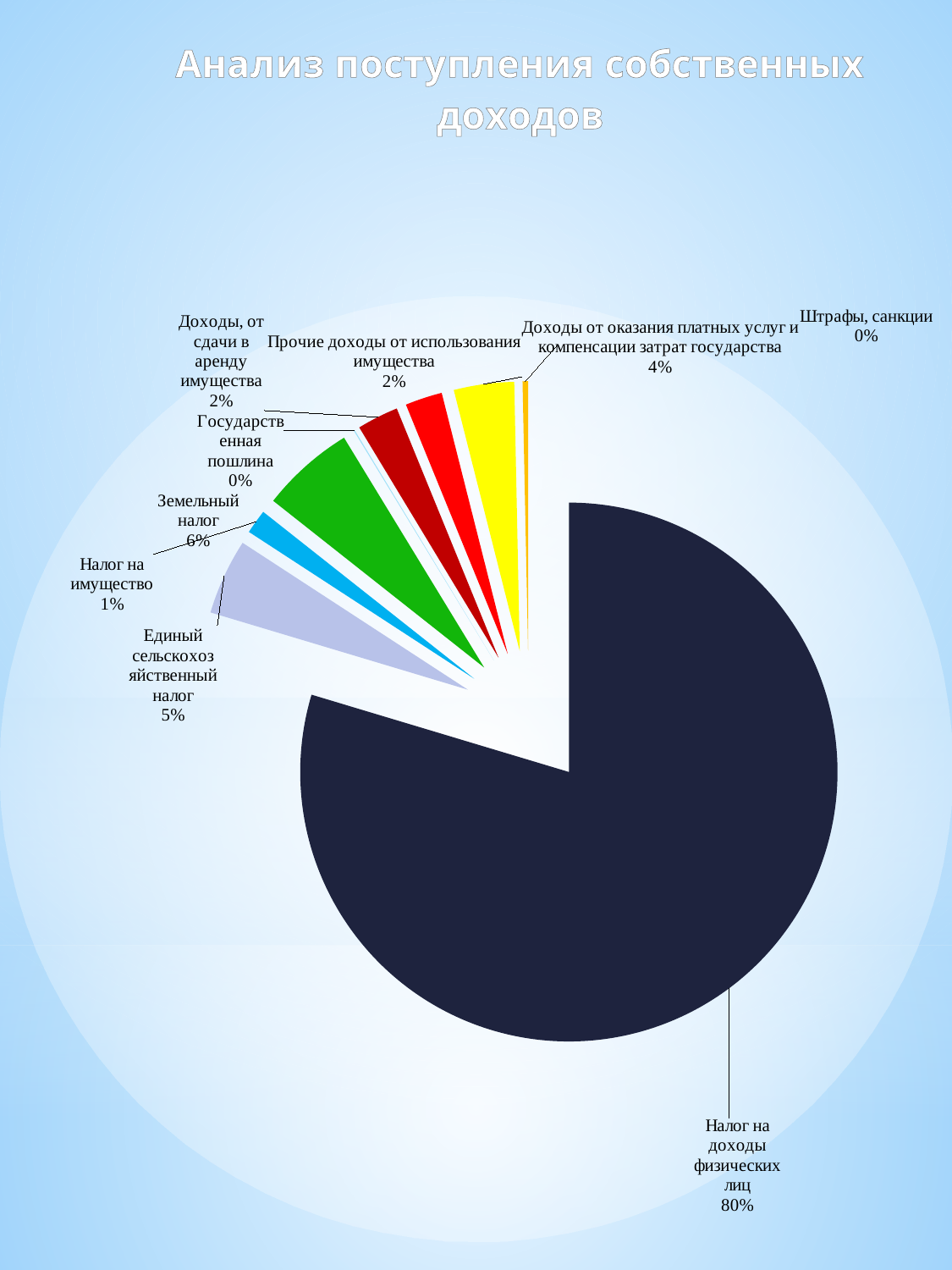
Which category has the largest share of the pie? Налог на доходы физических лиц What is the difference between the share for "Налог на доходы физических лиц" and the share for "Земельный налог"? 74% What kind of chart is shown on the slide? Pie chart What is the title of the chart on the slide? Анализ поступления собственных доходов What share of the pie does "Земельный налог" have? 6% What share of the pie does "Налог на имущество" have? 1% How many categories are shown in the pie chart? 9 What share of the pie does "Доходы от оказания платных услуг и компенсации затрат государства" have? 4% Which is larger: the share for "Земельный налог" or the share for "Единый сельскохозяйственный налог"? Земельный налог